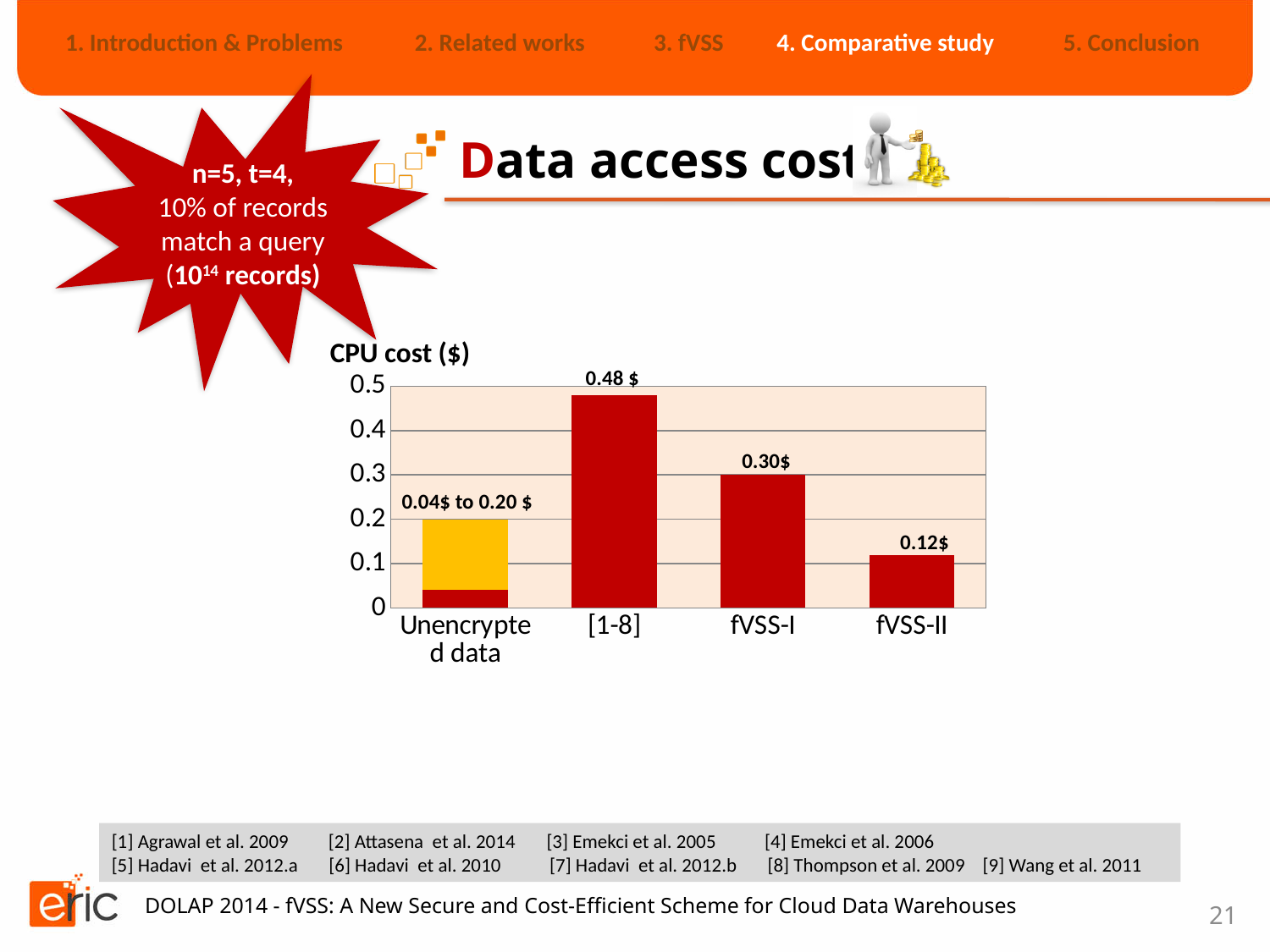
Is the CPU cost for [1-8] greater or less than 0.4? greater What is the CPU cost shown for fVSS-II? 0.12$ What is the CPU cost shown for [1-8]? 0.48 $ What is the CPU cost shown for fVSS-I? 0.30$ Which category has the highest CPU cost? [1-8] What is the difference in CPU cost between [1-8] and fVSS-I? 0.18 $ How many categories are shown on the x axis of the chart? 4 What CPU cost range is labelled for Unencrypted data? 0.04$ to 0.20 $ Which has a higher CPU cost, fVSS-I or fVSS-II? fVSS-I What is the difference in CPU cost between fVSS-I and fVSS-II? 0.18 $ What kind of chart is used to show the CPU cost? Bar chart Among [1-8], fVSS-I and fVSS-II, which has the lowest CPU cost? fVSS-II